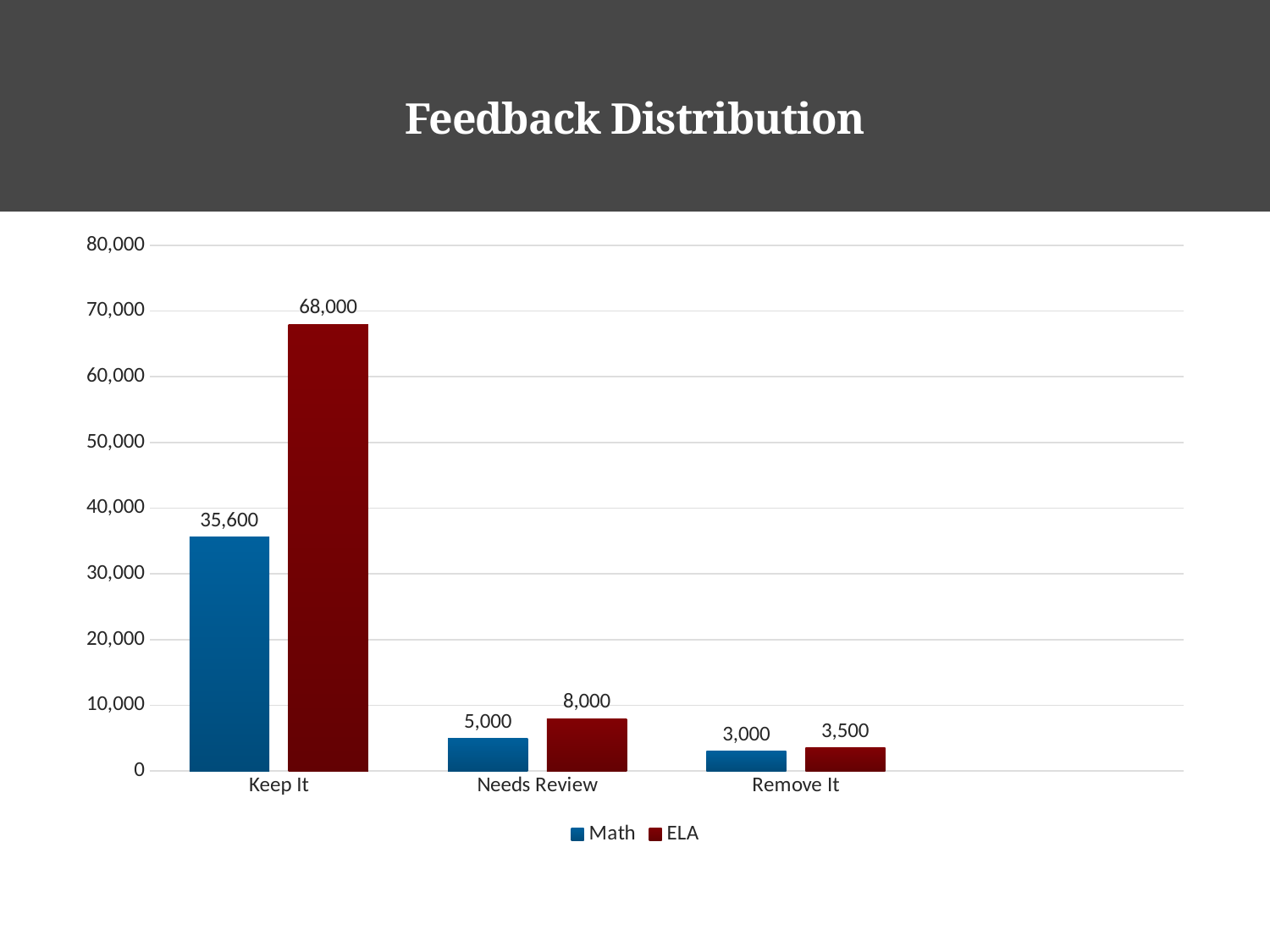
What is the Math value for Keep It? 35,600 Which is larger for Remove It, the Math value or the ELA value? ELA Which category has the highest ELA value? Keep It What is the difference between the ELA and Math values for Keep It? 32,400 Which category has the lowest Math value? Remove It How many categories are shown on the x axis? 3 What kind of chart is shown on the slide? bar chart What is the difference between the ELA and Math values for Needs Review? 3,000 What is the Math value for Remove It? 3,000 How many series does the legend list? 2 What is the ELA value for Needs Review? 8,000 Is the ELA value for Keep It greater or less than 60,000? greater